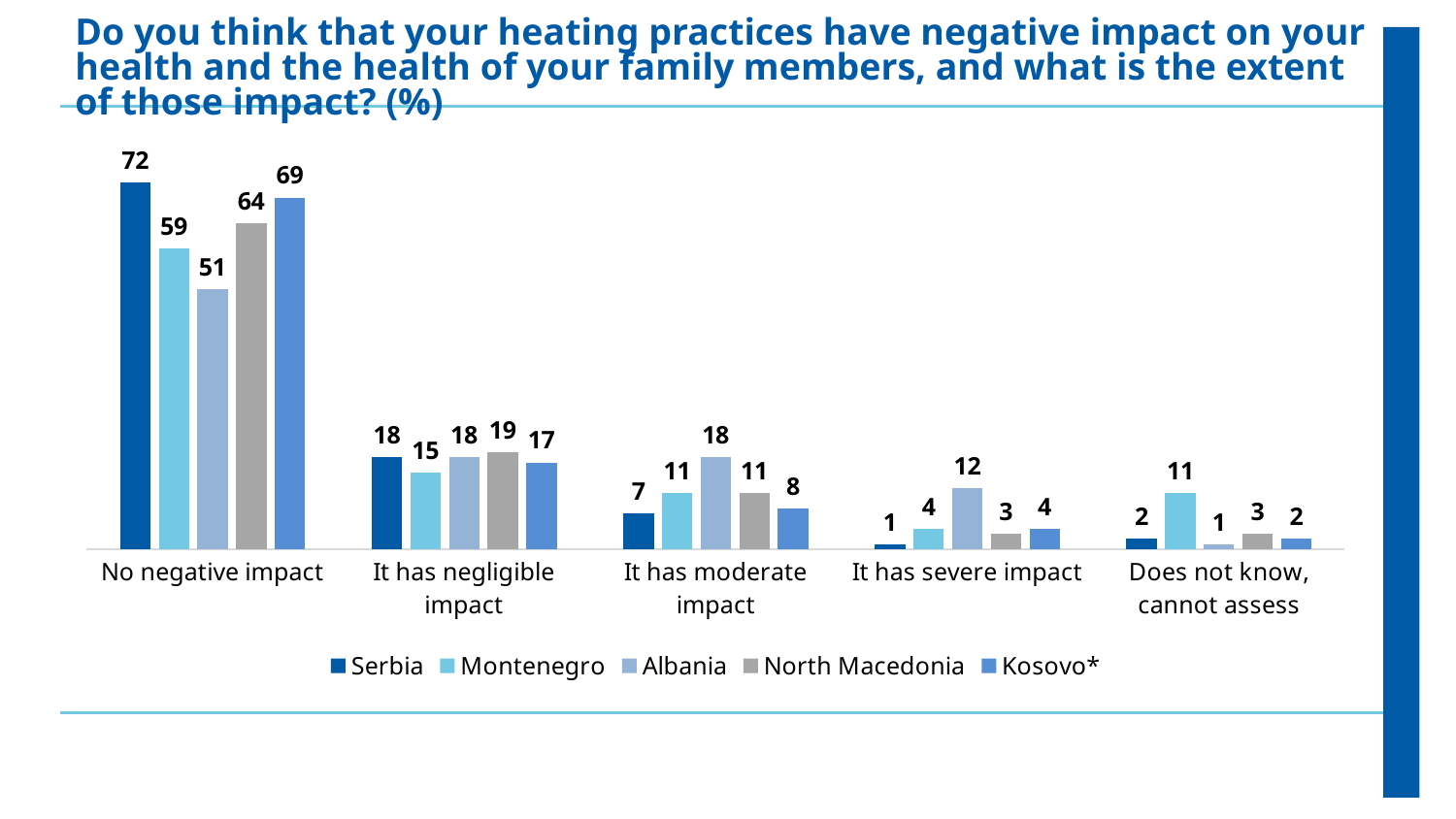
What is the value for Kosovo* in the 'It has moderate impact' category? 8 Which is larger in the 'It has negligible impact' category: North Macedonia or Montenegro? North Macedonia Which country has the lowest value in the 'It has severe impact' category? Serbia How many series does the legend list? 5 What is the difference between Serbia and Albania in the 'No negative impact' category? 21 What kind of chart is shown on the slide? Bar chart Which country has the highest value in the 'No negative impact' category? Serbia Which series is shown in the darkest blue colour in the legend? Serbia How many response categories are shown on the x axis? 5 What is the value for Albania in the 'It has moderate impact' category? 18 What is the value for Serbia in the 'No negative impact' category? 72 What is the value for Montenegro in the 'Does not know, cannot assess' category? 11